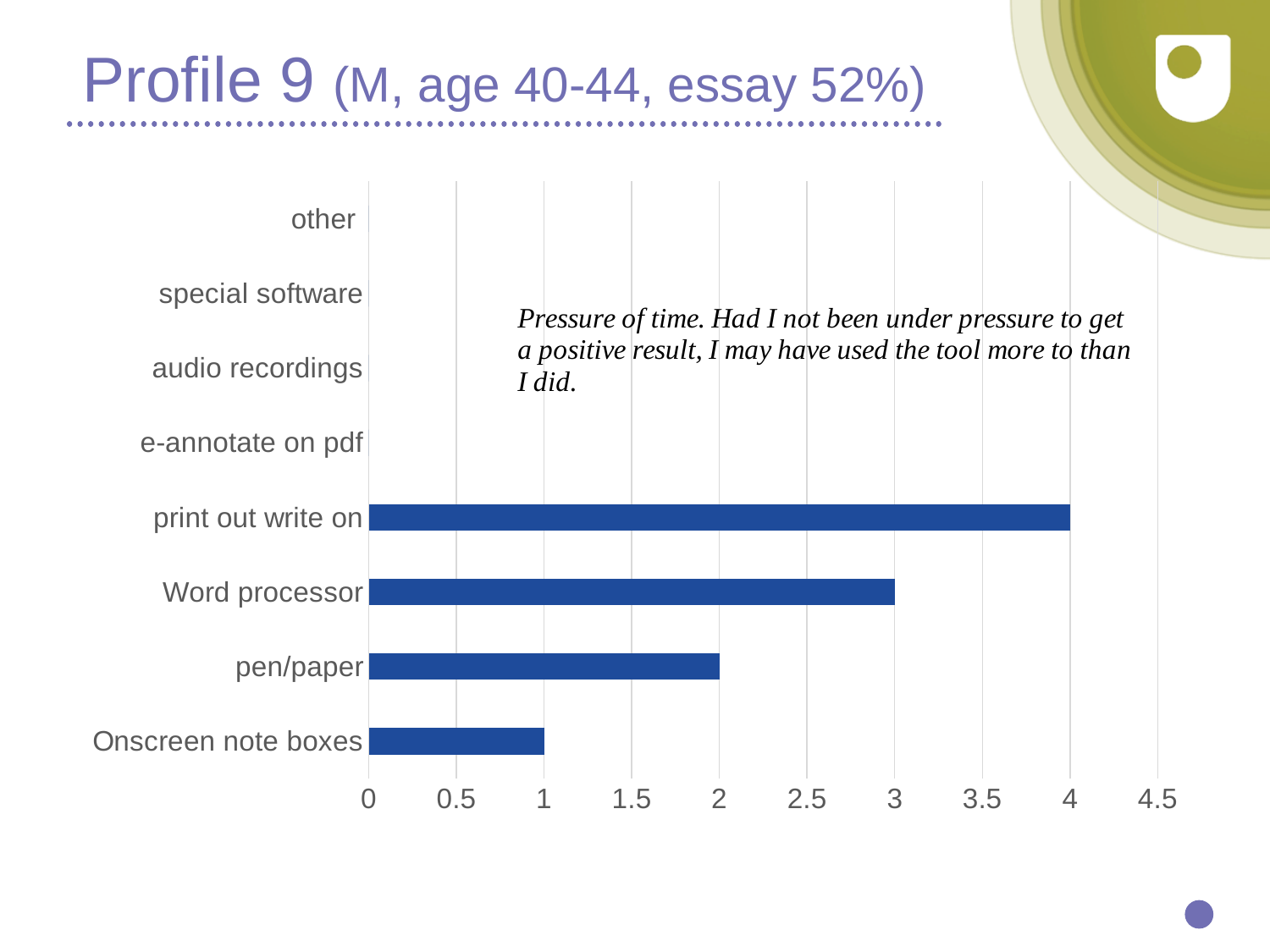
Which of the categories with a visible bar has the lowest value? Onscreen note boxes Is the value for 'Word processor' greater or less than 2.5? greater What is the value for 'print out write on'? 4 How many categories are listed on the vertical axis of the chart? 8 Which category has the highest value? print out write on Which is larger, the value for 'Word processor' or the value for 'pen/paper'? Word processor What kind of chart is shown on the slide? bar chart What is the value for 'Onscreen note boxes'? 1 What is the value for 'Word processor'? 3 What is the difference between the values for 'print out write on' and 'pen/paper'? 2 What is the value for 'pen/paper'? 2 What is the highest tick value shown on the horizontal axis? 4.5